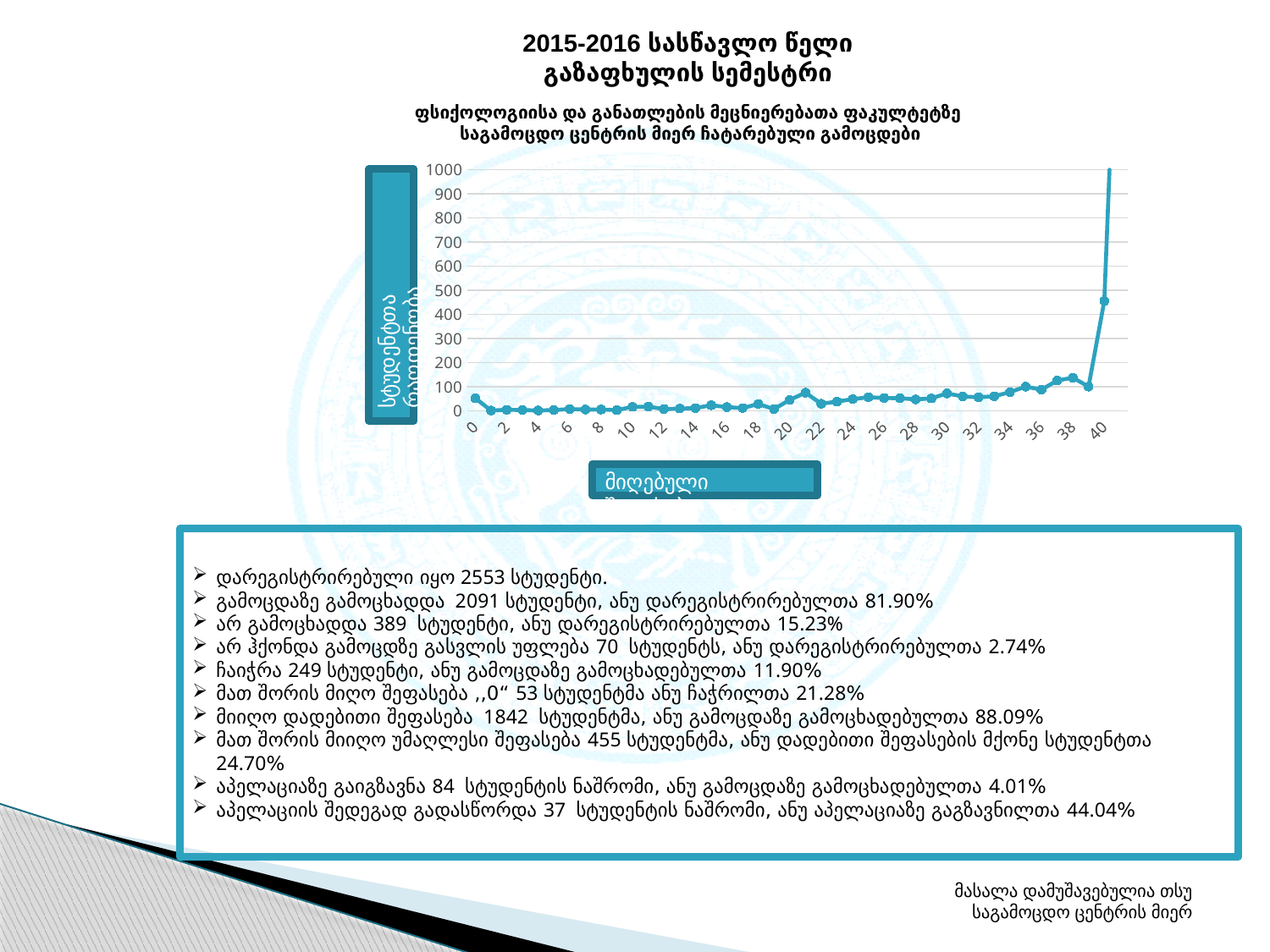
What is the highest tick label shown on the x-axis? 40 What kind of chart is shown on the slide? line chart Is the value at x = 39 greater or less than 300? less Between x = 20 and x = 40, do the values generally rise or fall? rise Is the value at x = 10 greater or less than 100? less What is the highest tick label shown on the y-axis? 1000 Is the value at x = 40 greater or less than 900? less Which is larger, the value at x = 40 or the value at x = 39? x = 40 Which is larger, the value at x = 0 or the value at x = 2? x = 0 Which is larger, the value at x = 30 or the value at x = 10? x = 30